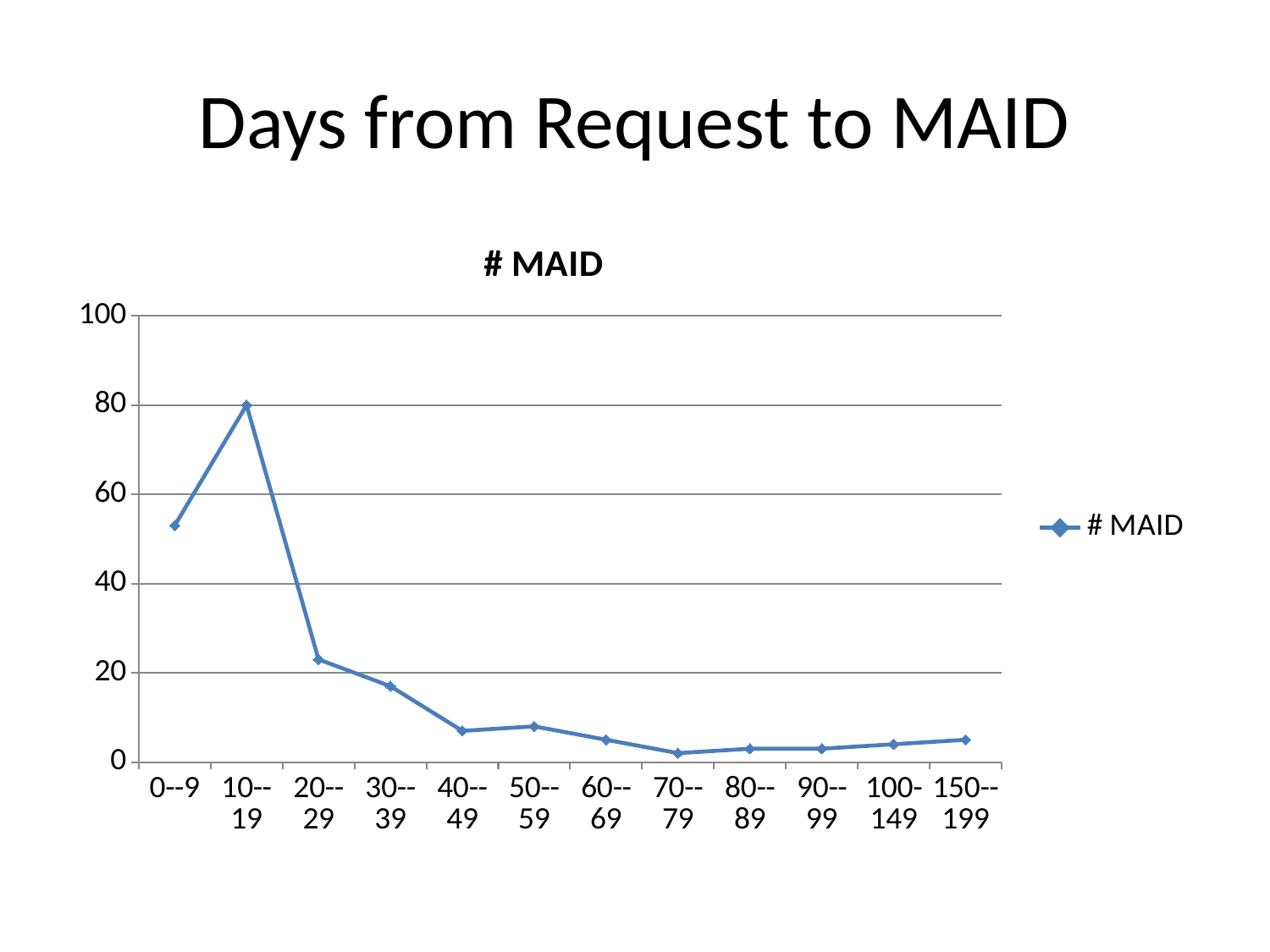
What is the value for the 10--19 category? 80 Which category has the highest value? 10--19 Is the value for 70--79 greater or less than 20? less Do the values rise or fall from 10--19 to 70--79? fall How many series does the legend list? 1 Is the value for 30--39 greater or less than 20? less Is the value for 0--9 greater or less than 40? greater Which is larger, the value for 10--19 or the value for 0--9? 10--19 What kind of chart is shown on the slide? line chart Which is larger, the value for 0--9 or the value for 20--29? 0--9 How many categories are shown on the x axis? 12